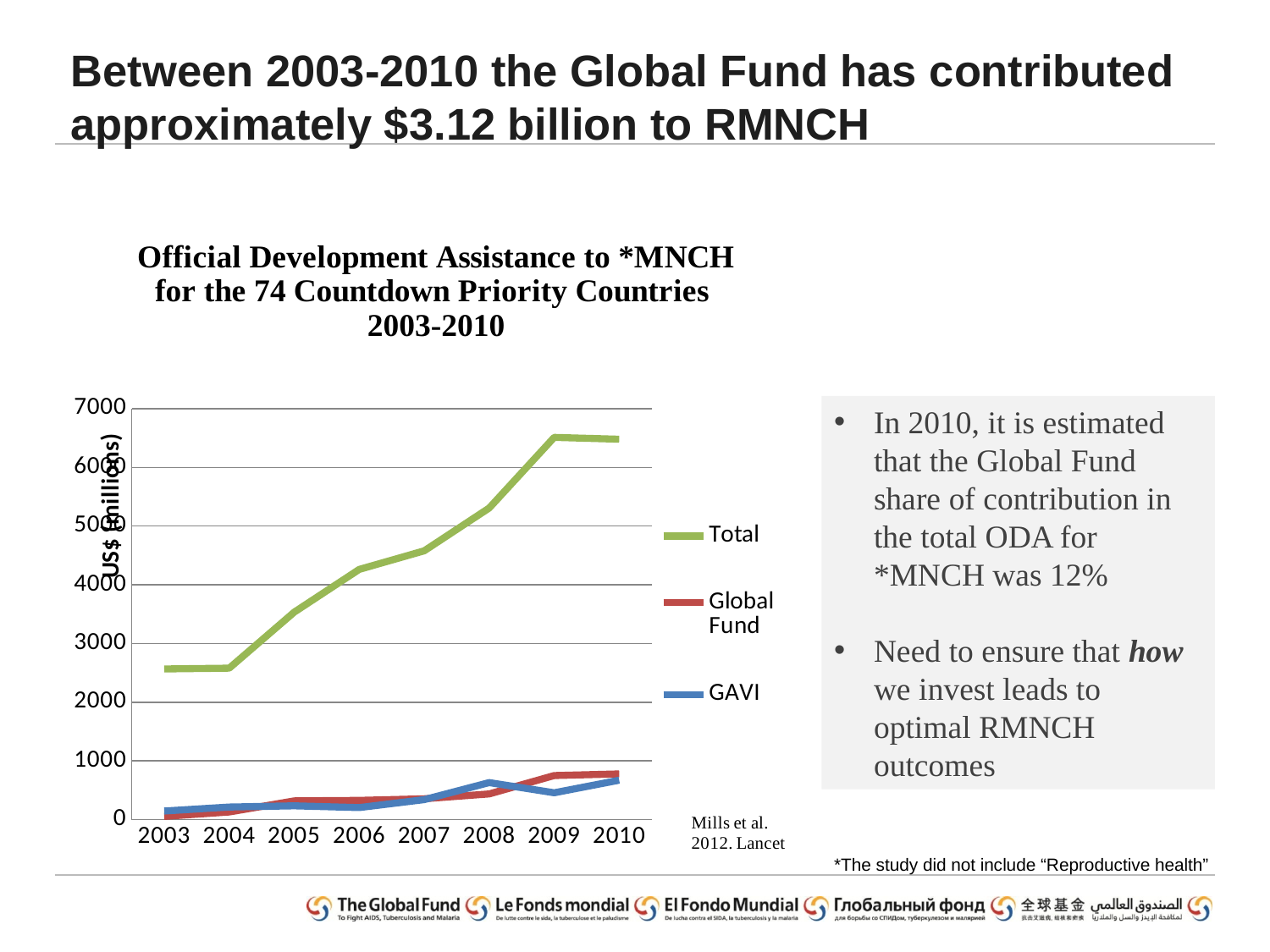
How many series does the legend list? 3 Does the Total series generally rise or fall from 2003 to 2010? rise Is the value for Total in 2010 greater or less than 6000? greater What is the label on the y axis? US$ (millions) Is the value for Total in 2003 greater or less than 3000? less What kind of chart is shown on the slide? line chart Which series has the larger value in 2010, Global Fund or GAVI? Global Fund Is the value for Total in 2006 greater or less than 4000? greater How many years are plotted along the x axis? 8 Which series has the larger value in 2008, Global Fund or GAVI? GAVI Which colour is used for the Total series? green